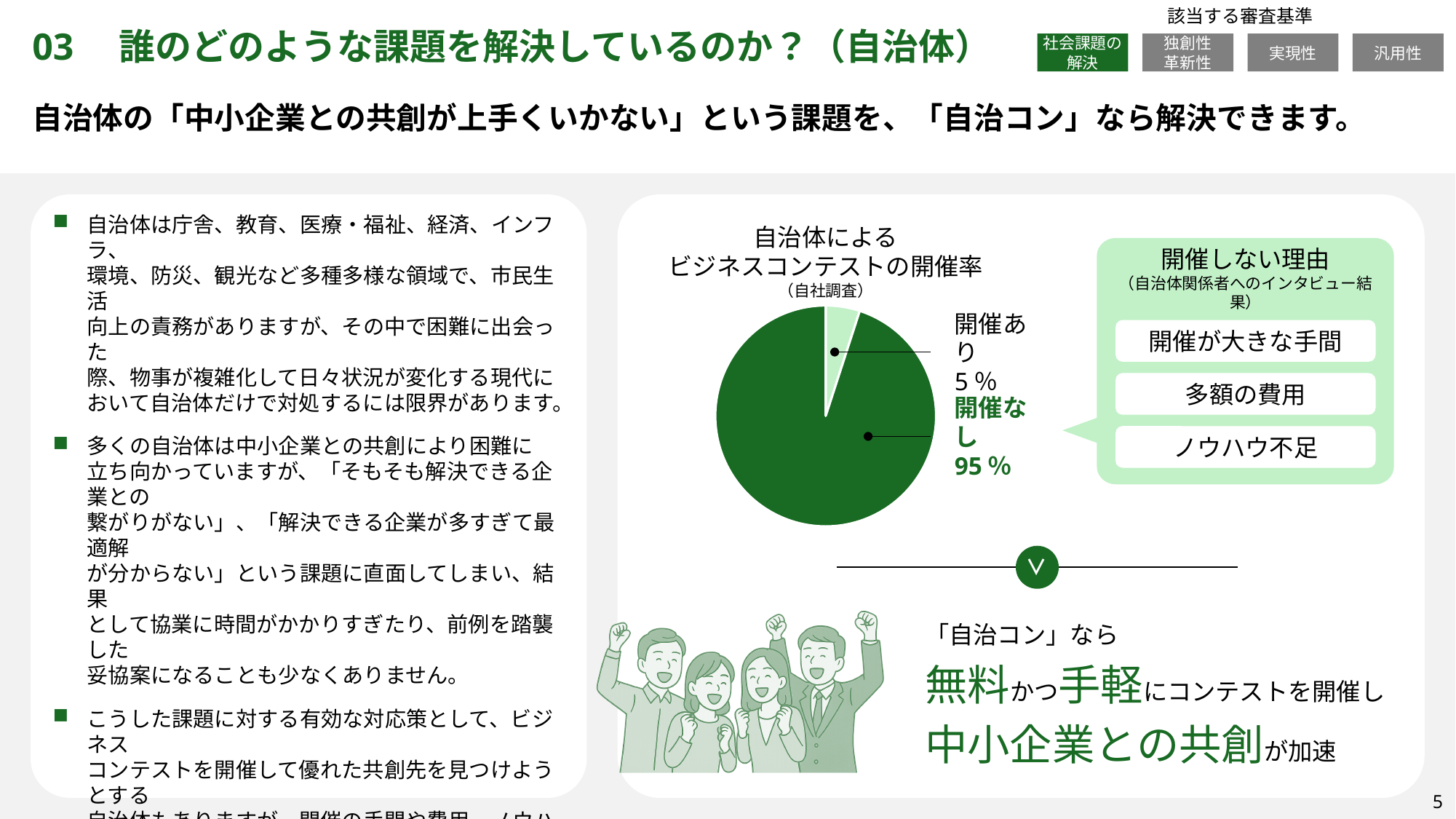
What share of the pie chart is 開催なし? 95% Which is larger in the pie chart, 開催あり or 開催なし? 開催なし What is the title of the pie chart? 自治体によるビジネスコンテストの開催率 Is the share for 開催なし in the pie chart greater or less than 50%? greater What kind of chart is shown on the slide? pie chart Is the share for 開催あり in the pie chart greater or less than 10%? less What share of the pie chart is 開催あり? 5% What is the difference in percentage points between 開催なし and 開催あり in the pie chart? 90 Which slice of the pie chart is the smallest? 開催あり Which slice of the pie chart is the largest? 開催なし What is the source noted under the pie chart title? 自社調査 How many slices does the pie chart have? 2